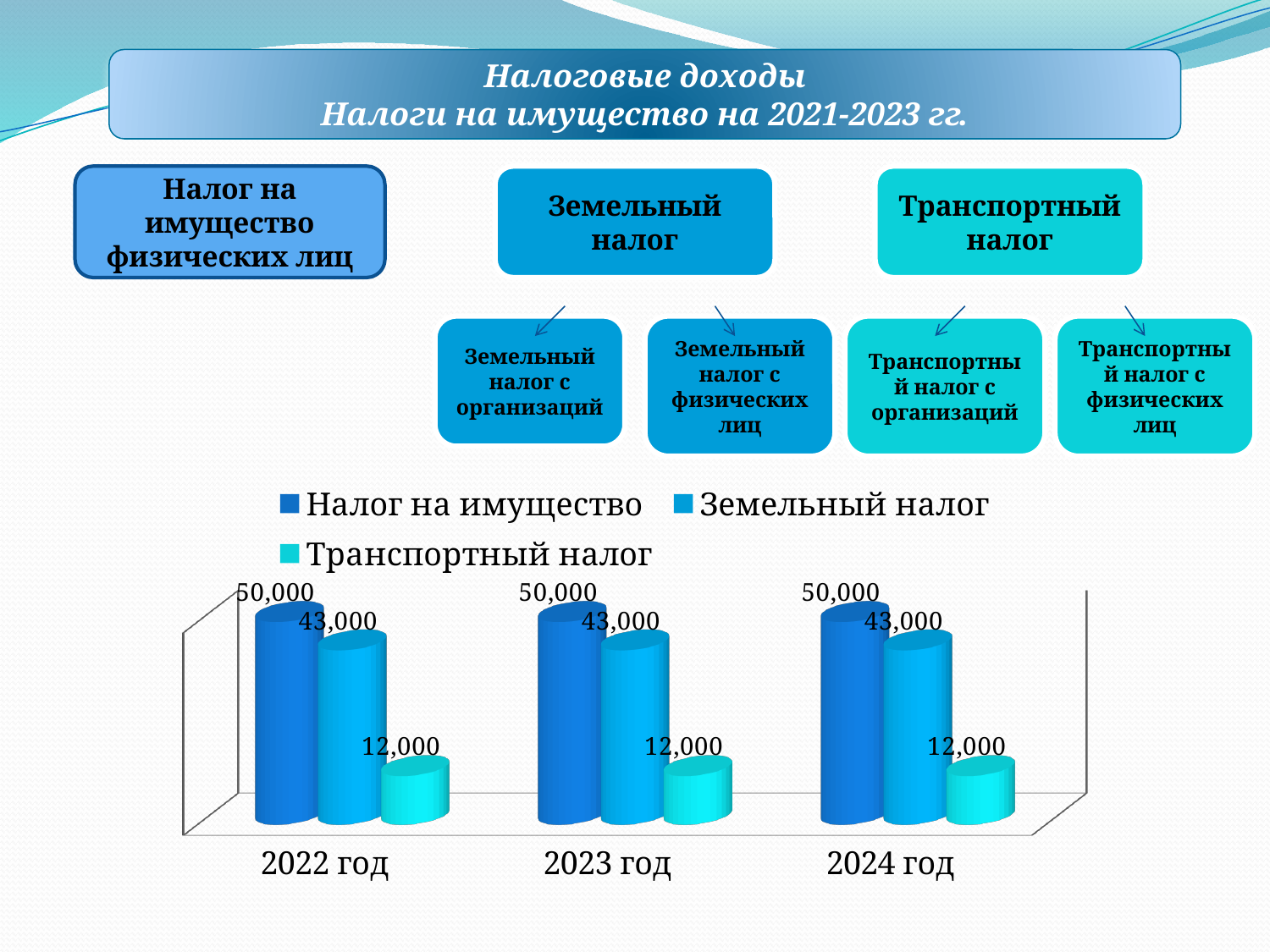
Which series has the lowest value in 2022 год? Транспортный налог What is the value for Налог на имущество in 2022 год? 50,000 What is the difference between Налог на имущество and Земельный налог in 2023 год? 7,000 Which is larger in 2024 год: Земельный налог or Транспортный налог? Земельный налог How many year categories are shown on the x axis of the chart? 3 What is the value for Земельный налог in 2023 год? 43,000 What is the difference between Земельный налог and Транспортный налог in 2022 год? 31,000 Which series has the highest value in 2024 год? Налог на имущество How many series does the chart legend list? 3 Does the value for Налог на имущество rise, fall, or stay the same from 2022 год to 2024 год? Stays the same What kind of chart is shown on the slide? Bar chart What is the value for Транспортный налог in 2024 год? 12,000